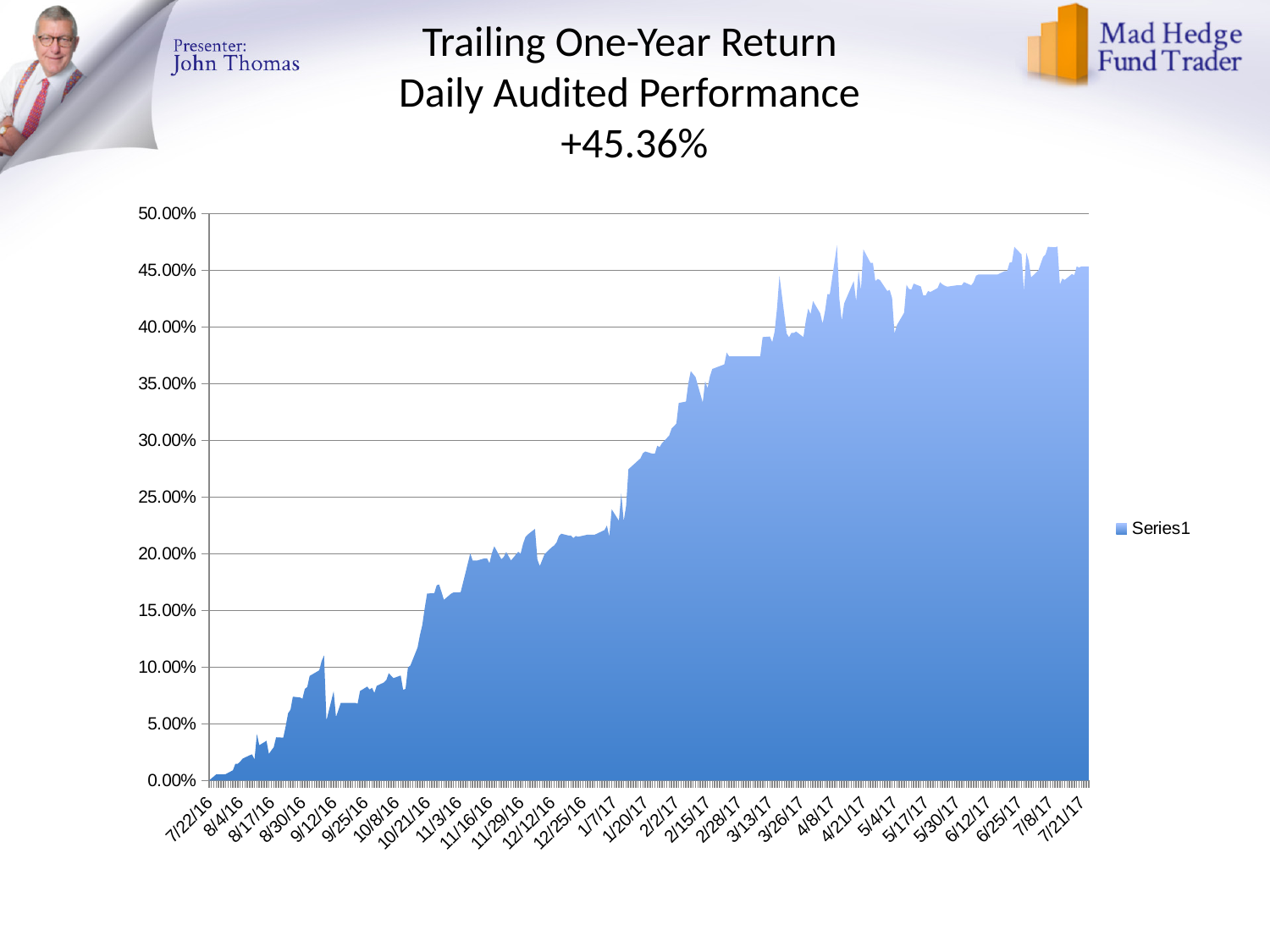
What kind of chart is shown on the slide? area chart Is the value for 7/22/16 greater or less than 5.00%? less What trailing one-year return figure is stated in the slide title? +45.36% What is the name of the series shown in the legend? Series1 Is the value for 12/25/16 greater or less than 25.00%? less Is the value for 10/21/16 greater or less than 10.00%? greater Which of the two dates has the larger value, 9/12/16 or 3/13/17? 3/13/17 Do the values generally rise or fall from 7/22/16 to 7/21/17? rise How many series does the legend list? 1